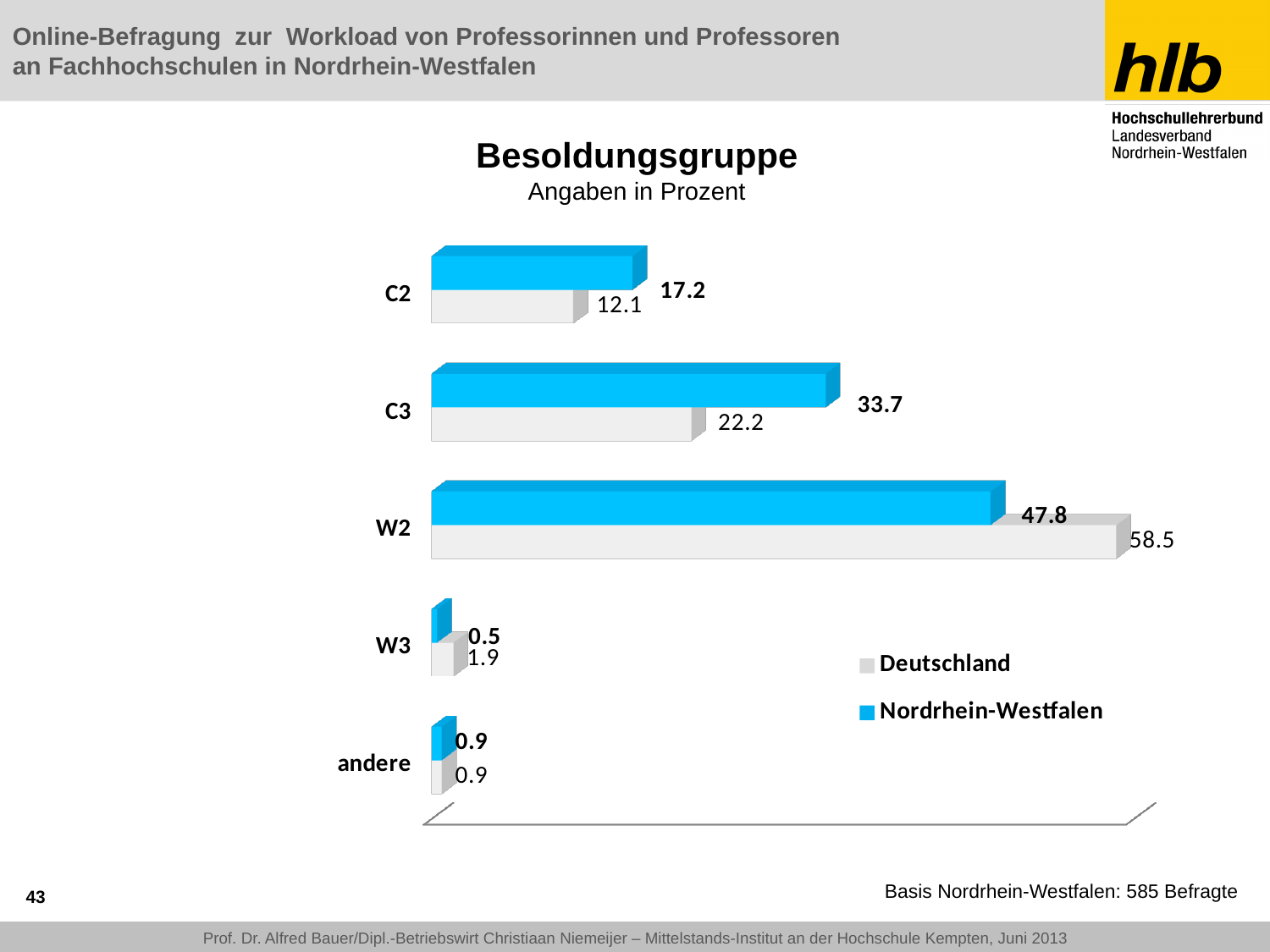
What is the difference between the Nordrhein-Westfalen and Deutschland values for C3? 11.5 What is the value for Nordrhein-Westfalen in the C3 category? 33.7 What is the difference between the Deutschland and Nordrhein-Westfalen values for W2? 10.7 What is the value for Deutschland in the C2 category? 12.1 What kind of chart is shown on the slide? Bar chart How many series does the legend list? 2 What is the value for Deutschland in the W2 category? 58.5 What is the value for Nordrhein-Westfalen in the W3 category? 0.5 Which category has the lowest value for Deutschland? andere For C2, which is larger: the Deutschland value or the Nordrhein-Westfalen value? Nordrhein-Westfalen How many categories are shown on the chart? 5 Which category has the highest value for Nordrhein-Westfalen? W2